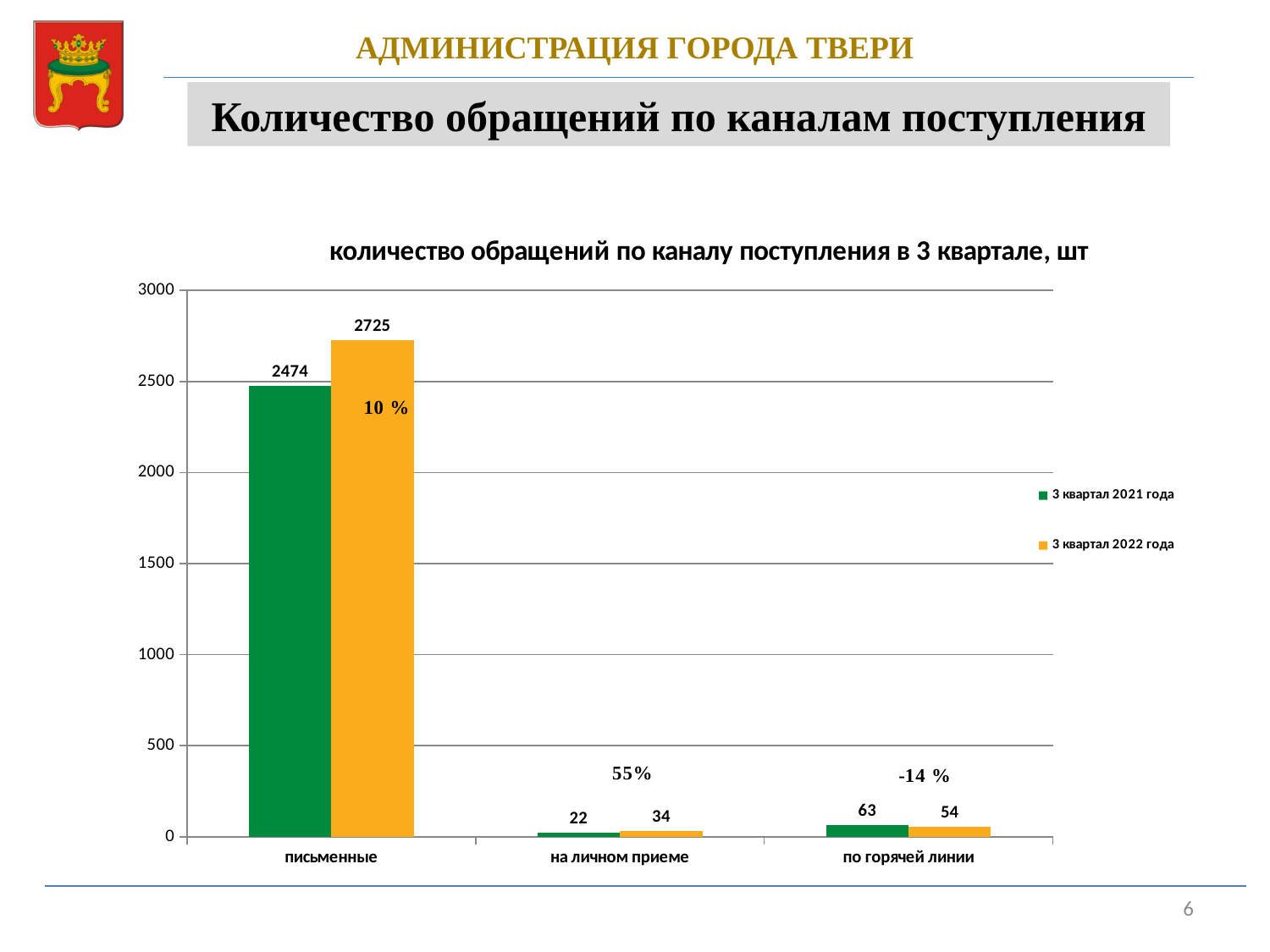
Which is larger for по горячей линии: 3 квартал 2021 года or 3 квартал 2022 года? 3 квартал 2021 года How many categories are shown on the x axis? 3 Which category has the lowest value in 3 квартал 2021 года? на личном приеме Which category has the highest value in 3 квартал 2022 года? письменные What is the value for письменные in 3 квартал 2022 года? 2725 What is the difference between the 3 квартал 2022 года and 3 квартал 2021 года values for письменные? 251 Is the value for письменные in 3 квартал 2021 года greater or less than 2000? greater What kind of chart is shown? bar chart What is the value for на личном приеме in 3 квартал 2022 года? 34 How many series does the legend list? 2 What is the value for письменные in 3 квартал 2021 года? 2474 What is the value for по горячей линии in 3 квартал 2021 года? 63